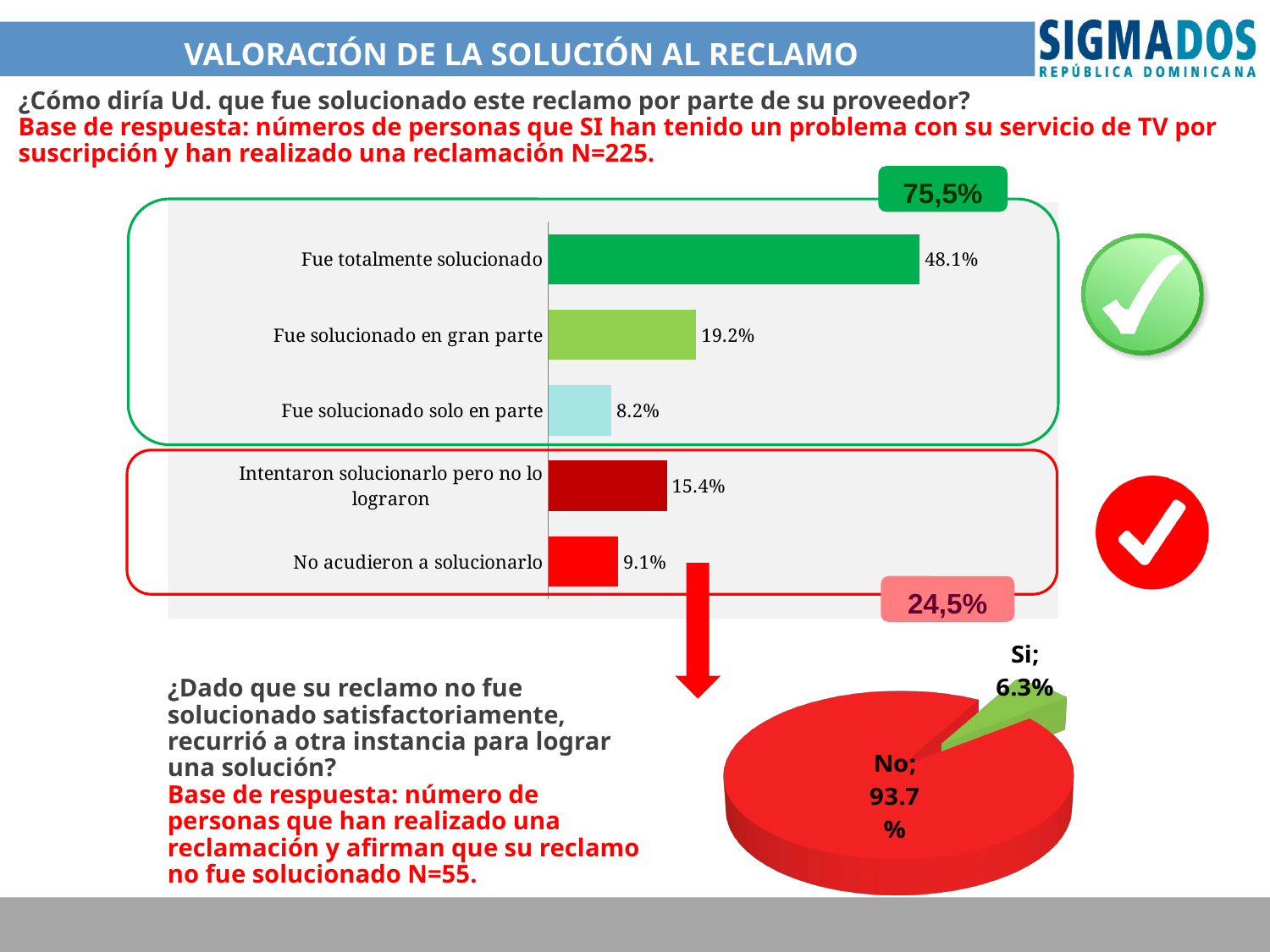
In the bar chart, what is the value for "No acudieron a solucionarlo"? 9.1% In the pie chart, what is the share for "Si"? 6.3% What type of chart is the bottom-right chart on the slide? Pie chart In the bar chart, which is larger: "Fue solucionado en gran parte" or "Intentaron solucionarlo pero no lo lograron"? Fue solucionado en gran parte In the bar chart, which category has the lowest value? Fue solucionado solo en parte In the bar chart, what is the difference between "Fue totalmente solucionado" and "Fue solucionado en gran parte"? 28.9% What type of chart is the top chart on the slide? Bar chart In the pie chart, what is the share for "No"? 93.7% In the bar chart, what is the value for "Fue totalmente solucionado"? 48.1% How many categories does the bar chart show? 5 In the bar chart, which category has the highest value? Fue totalmente solucionado In the bar chart, what is the value for "Intentaron solucionarlo pero no lo lograron"? 15.4%